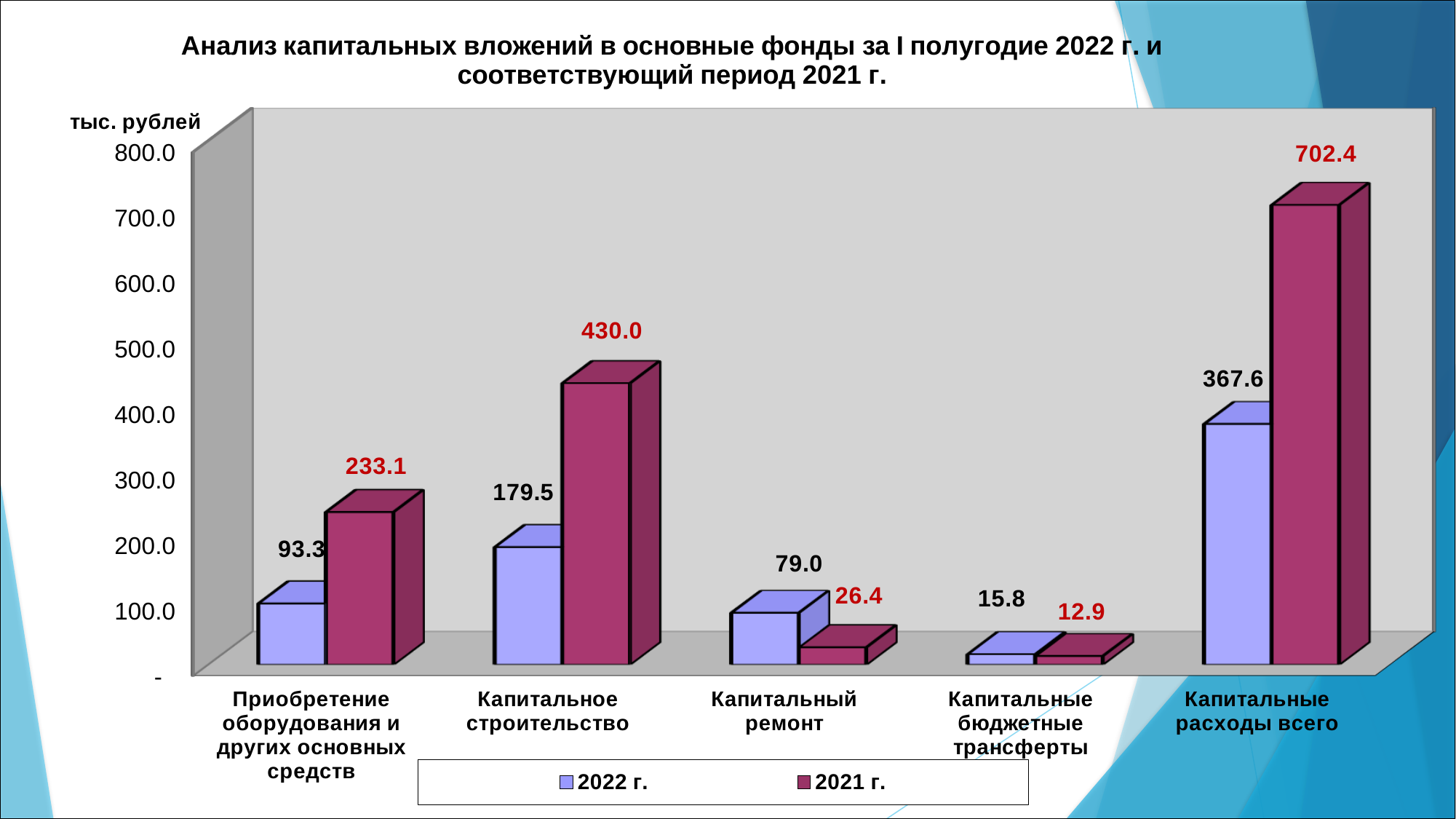
What is the value for 2022 г. in the Капитальный ремонт category? 79.0 Which category has the lowest value for 2021 г.? Капитальные бюджетные трансферты How many series does the legend list? 2 What is the value for 2021 г. in the Капитальные расходы всего category? 702.4 What kind of chart is shown on the slide? Bar chart What is the difference between the 2021 г. and 2022 г. values for Капитальные расходы всего? 334.8 How many categories are shown on the x axis? 5 What is the value for 2022 г. in the Капитальное строительство category? 179.5 Which category has the highest value for 2022 г.? Капитальные расходы всего What is the value for 2021 г. in the Приобретение оборудования и других основных средств category? 233.1 What unit is shown on the vertical axis label? тыс. рублей Which is larger in the Капитальный ремонт category: the 2022 г. value or the 2021 г. value? 2022 г.